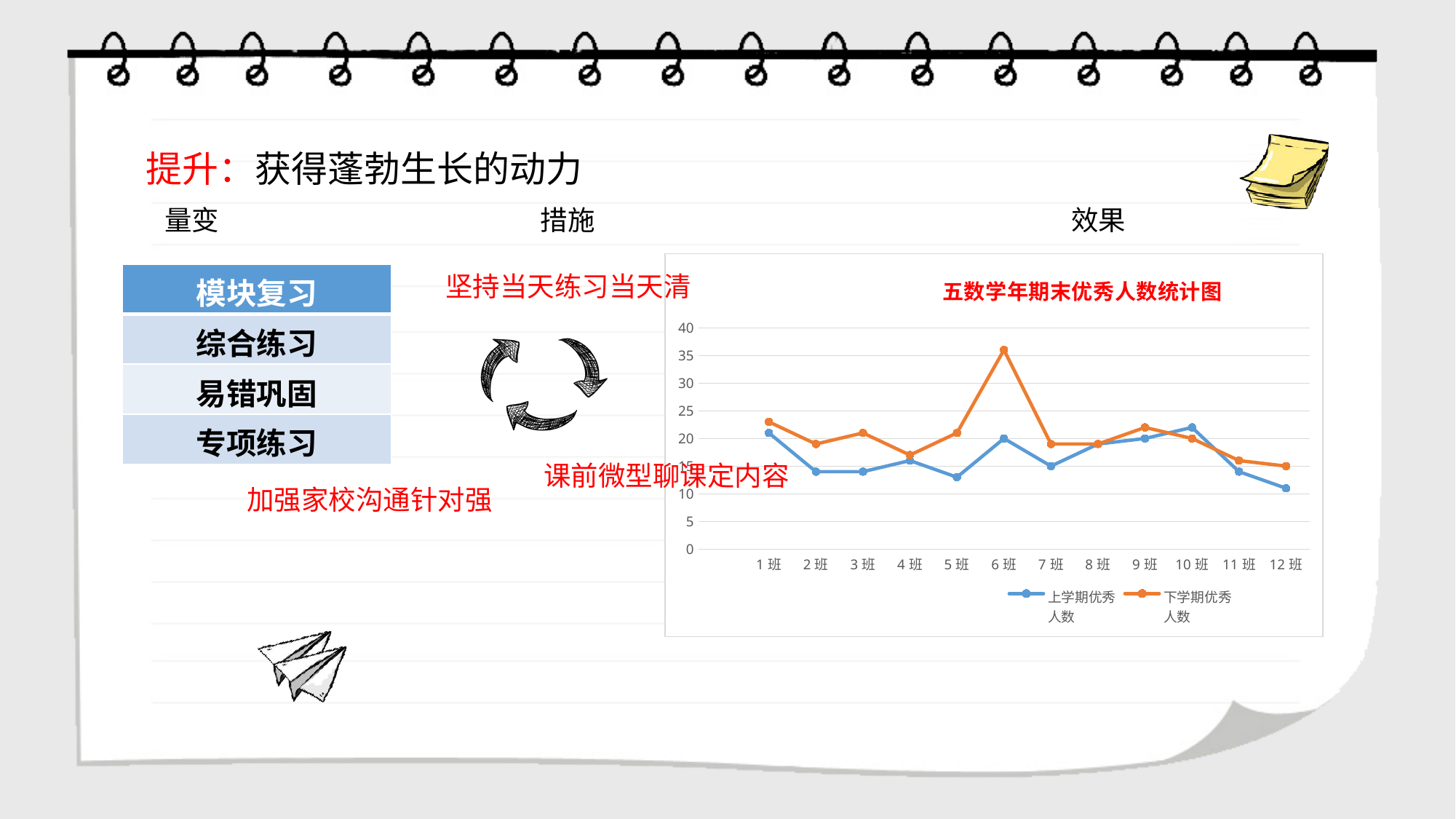
For the 下学期优秀人数 series, which class has the highest value? 6 班 How many series does the chart's legend list? 2 How many classes are plotted along the x axis of the chart? 12 Does the 上学期优秀人数 series rise or fall from 10 班 to 12 班? fall For 6 班, which series has the larger value, 上学期优秀人数 or 下学期优秀人数? 下学期优秀人数 Which series is drawn in orange in the chart? 下学期优秀人数 For the 上学期优秀人数 series, which class has the lowest value? 12 班 What kind of chart is shown on the slide? line chart Is the 上学期优秀人数 value for 12 班 greater or less than 15? less Is the 下学期优秀人数 value for 1 班 greater or less than 20? greater What is the title of the chart? 五数学年期末优秀人数统计图 Is the 下学期优秀人数 value for 6 班 greater or less than 30? greater